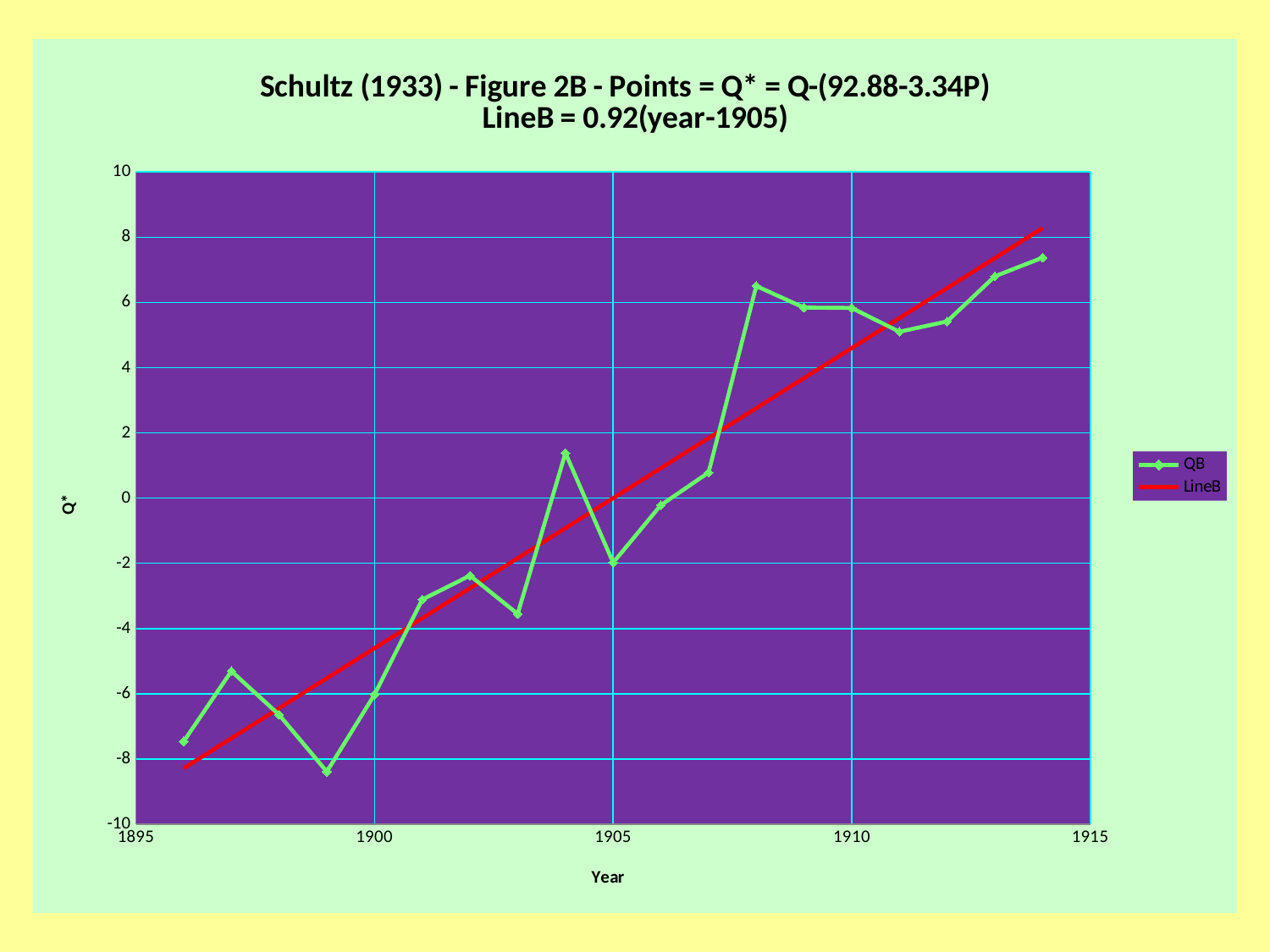
In which year does the QB series reach its highest value? 1914 Is the QB value for 1905 greater or less than 0? less What colour is the LineB series drawn in? Red Which is larger, the QB value for 1904 or for 1905? 1904 In which year does the QB series reach its lowest value? 1899 Is the QB value for 1910 greater or less than 4? greater How many series does the legend list? 2 Overall, do the QB values rise or fall as the year increases from 1896 to 1914? Rise What kind of chart is shown on the slide? Line chart Is the QB value for 1900 greater or less than -4? less How many data points does the QB series have? 19 What are the names of the two series in the legend? QB and LineB